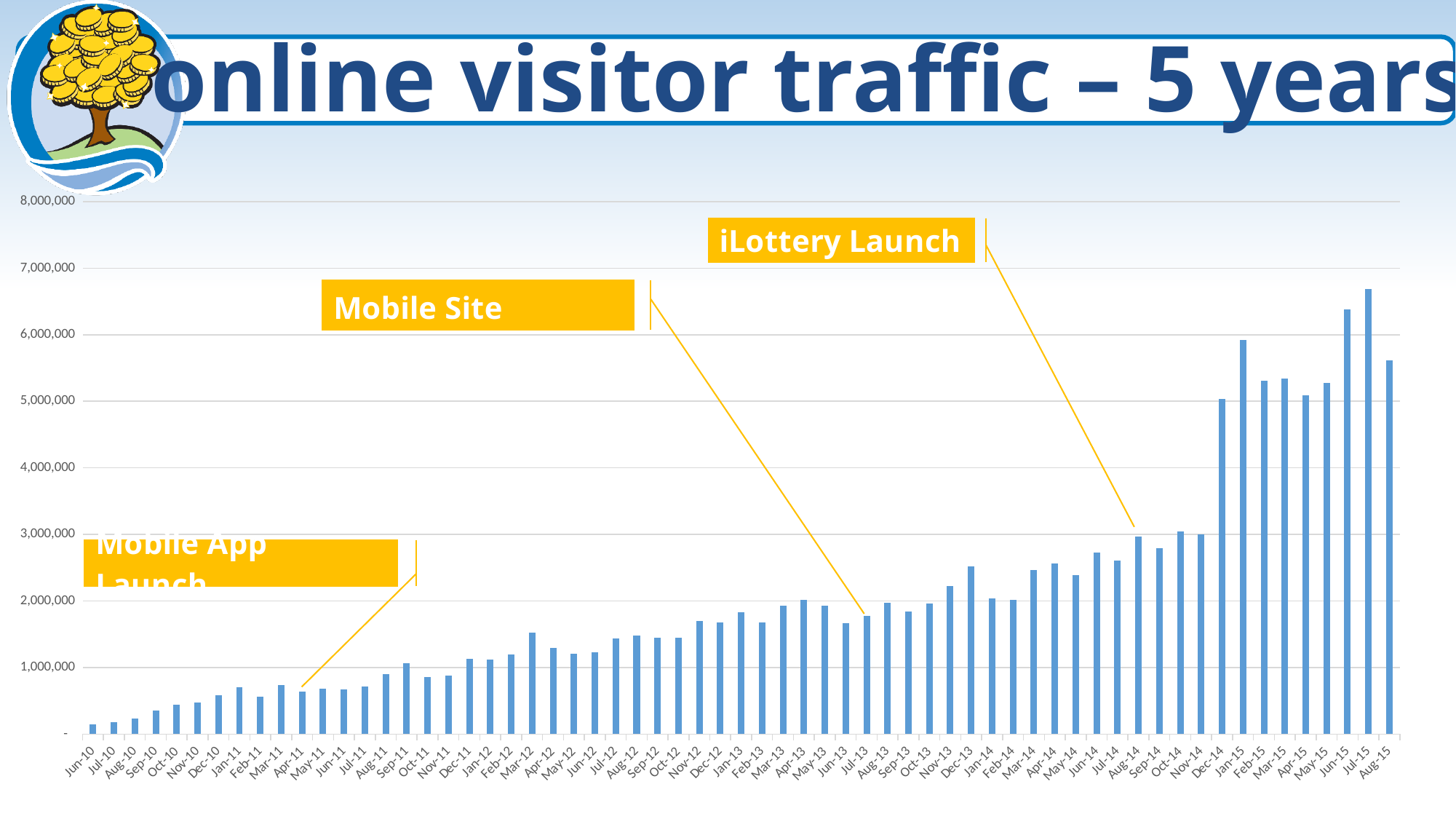
What kind of chart is shown on the slide? bar chart Is the value for Aug-15 greater or less than 5,000,000? greater Is the value for Jul-15 greater or less than 6,000,000? greater Is the value for Jun-10 greater or less than 1,000,000? less Which launch event is annotated on the chart around Aug-14? iLottery Launch Overall, does online visitor traffic rise or fall from Jun-10 to Aug-15? rise Which month has the highest online visitor traffic? Jul-15 Which month has the lowest online visitor traffic? Jun-10 Which month has higher visitor traffic, Jan-15 or Feb-15? Jan-15 Which month has higher visitor traffic, Nov-14 or Dec-14? Dec-14